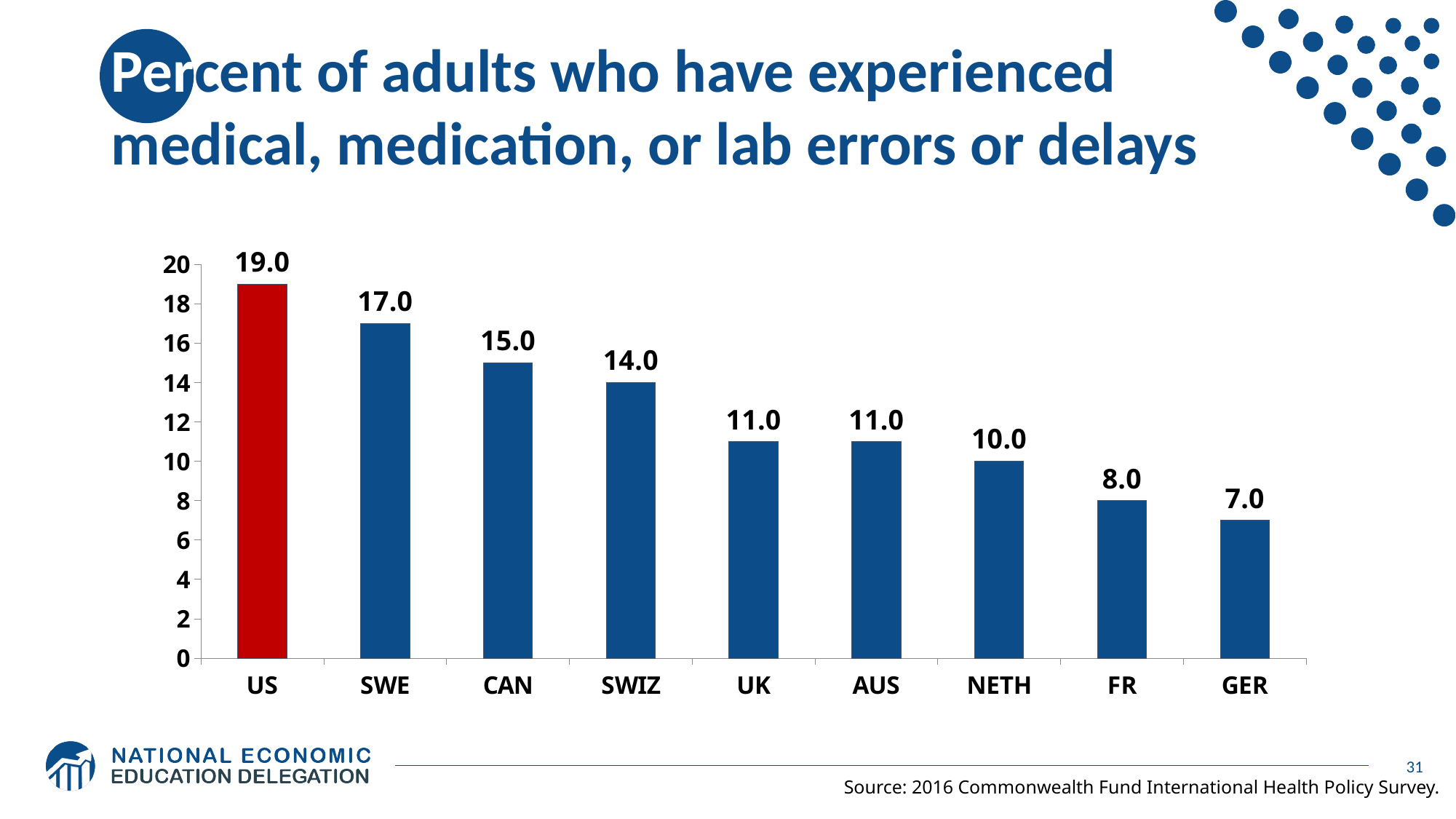
Which country has the highest value? US Which is larger, the value for FR or the value for NETH? NETH What is the difference between the values for US and SWE? 2.0 What is the value for US? 19.0 What is the value for SWIZ? 14.0 How many countries are shown on the chart? 9 What is the difference between the values for CAN and GER? 8.0 What kind of chart is shown on the slide? bar chart Do the values rise or fall from left to right along the x axis? fall Which country has the lowest value? GER What is the value for NETH? 10.0 Which bar is coloured red rather than blue? US